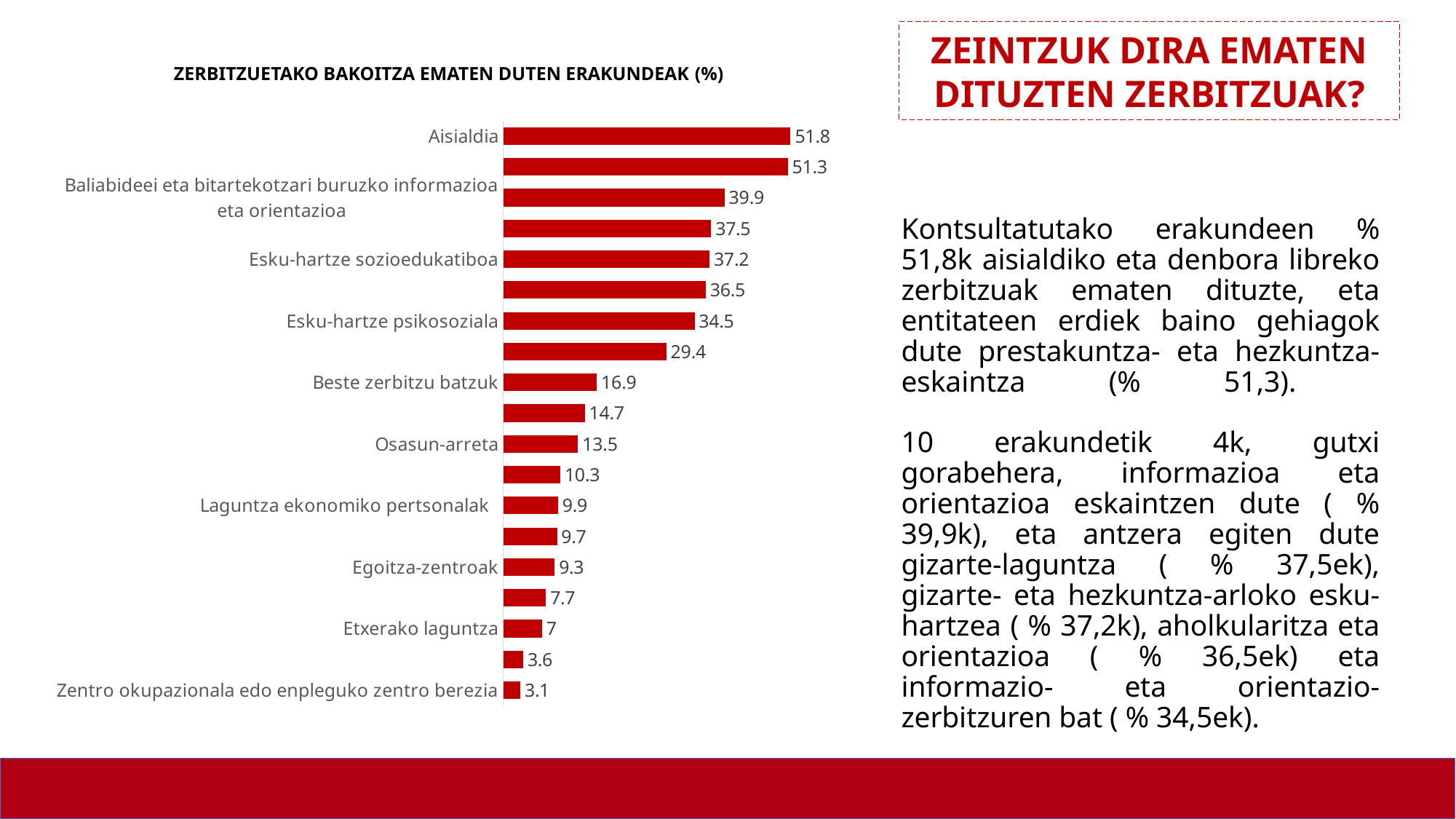
Which is larger, the value for Beste zerbitzu batzuk or the value for Osasun-arreta? Beste zerbitzu batzuk How many bars does the chart show? 19 Which labelled category has the highest value? Aisialdia What is the value for Aisialdia? 51.8 What is the value for Osasun-arreta? 13.5 What is the difference between the values for Aisialdia and Esku-hartze psikosoziala? 17.3 What is the title of the chart? ZERBITZUETAKO BAKOITZA EMATEN DUTEN ERAKUNDEAK (%) What is the value for Zentro okupazionala edo enpleguko zentro berezia? 3.1 What is the value for Etxerako laguntza? 7 What is the value for Esku-hartze sozioedukatiboa? 37.2 Which labelled category has the lowest value? Zentro okupazionala edo enpleguko zentro berezia What kind of chart is shown on the slide? Bar chart